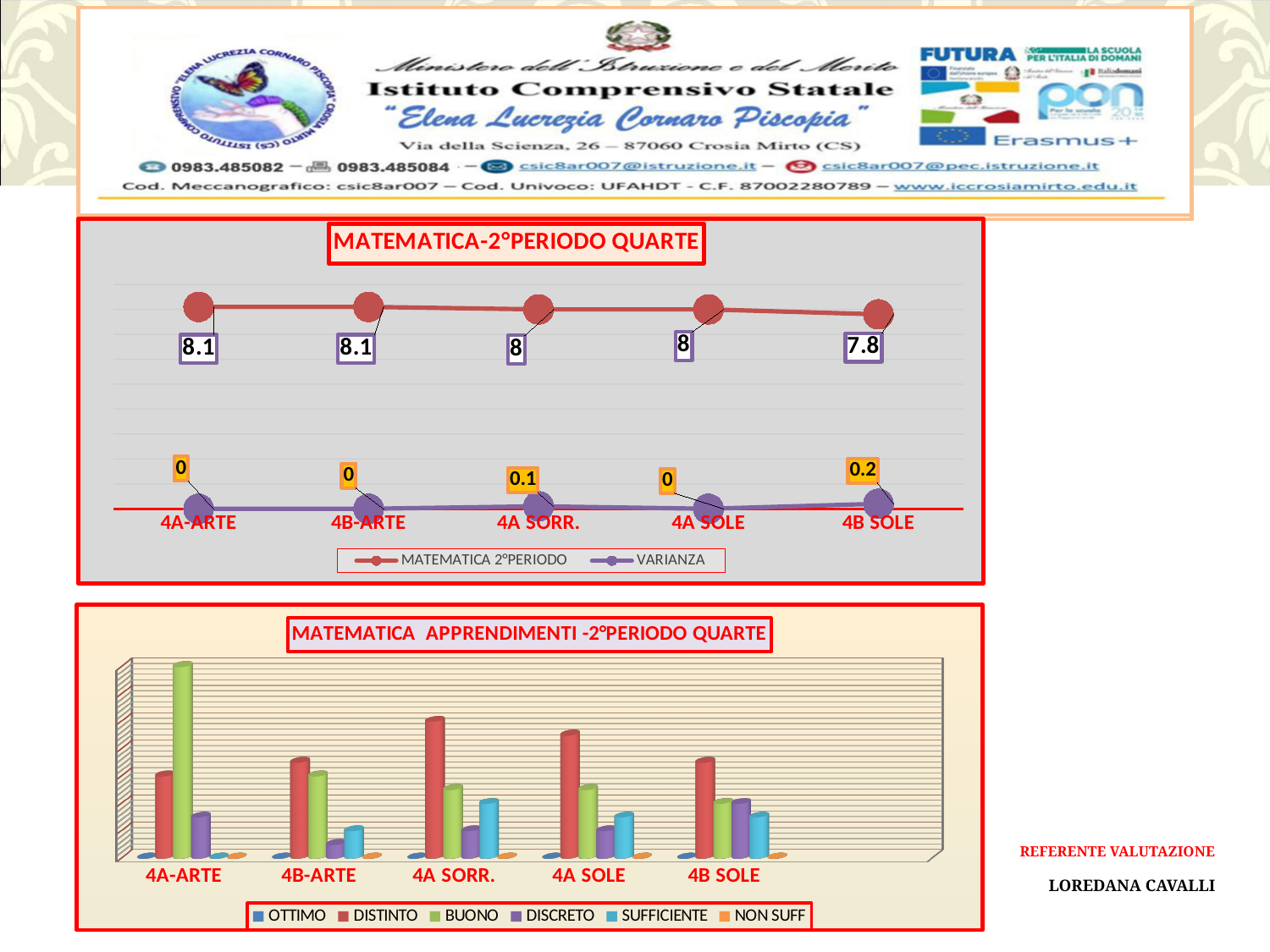
In the chart titled MATEMATICA-2°PERIODO QUARTE, what is the MATEMATICA 2°PERIODO value for 4B SOLE? 7.8 In the chart titled MATEMATICA-2°PERIODO QUARTE, which category has the highest VARIANZA value? 4B SOLE In the chart titled MATEMATICA-2°PERIODO QUARTE, does the MATEMATICA 2°PERIODO series rise or fall from 4A-ARTE to 4B SOLE? fall In the chart titled MATEMATICA APPRENDIMENTI -2°PERIODO QUARTE, how many series does the legend list? 6 In the chart titled MATEMATICA APPRENDIMENTI -2°PERIODO QUARTE, which class has the tallest BUONO bar? 4A-ARTE In the chart titled MATEMATICA-2°PERIODO QUARTE, what is the VARIANZA value for 4A SORR.? 0.1 In the chart titled MATEMATICA-2°PERIODO QUARTE, how many series does the legend list? 2 In the chart titled MATEMATICA-2°PERIODO QUARTE, what is the difference between the MATEMATICA 2°PERIODO values for 4A-ARTE and 4B SOLE? 0.3 What kind of chart is the one titled MATEMATICA APPRENDIMENTI -2°PERIODO QUARTE? bar chart In the chart titled MATEMATICA APPRENDIMENTI -2°PERIODO QUARTE, for 4A SORR., which is larger: the DISTINTO bar or the BUONO bar? DISTINTO In the chart titled MATEMATICA-2°PERIODO QUARTE, how many categories are shown on the x axis? 5 In the chart titled MATEMATICA-2°PERIODO QUARTE, which category has the lowest MATEMATICA 2°PERIODO value? 4B SOLE